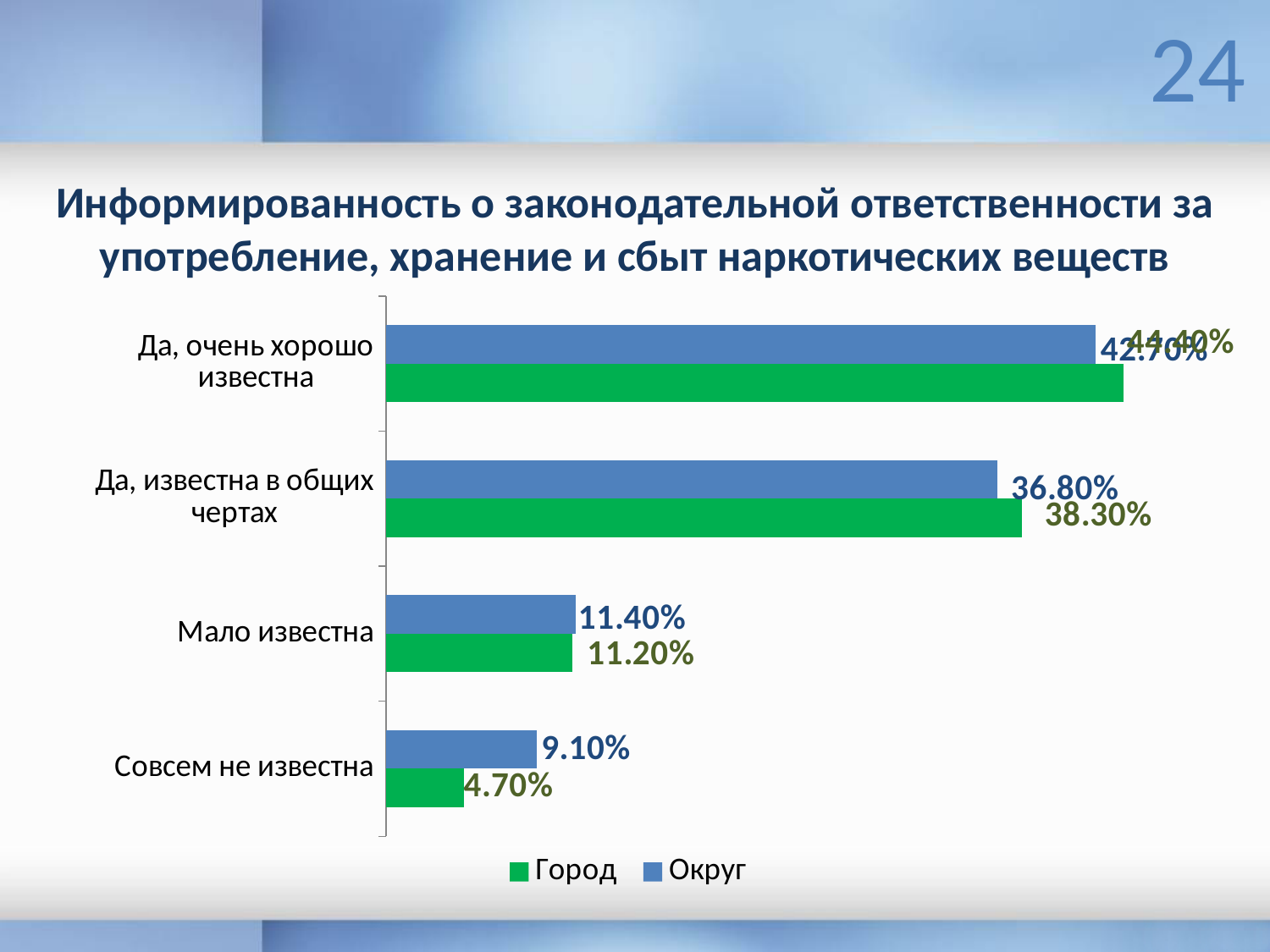
What is the value for Город in the category "Совсем не известна"? 4.70% What is the value for Округ in the category "Совсем не известна"? 9.10% What is the difference between the Округ and Город values in the category "Совсем не известна"? 4.40% What is the value for Округ in the category "Мало известна"? 11.40% What kind of chart is shown on the slide? bar chart In the category "Совсем не известна", which series has the larger value, Город or Округ? Округ How many categories are shown on the chart? 4 How many series does the legend list? 2 What is the value for Округ in the category "Да, известна в общих чертах"? 36.80% Which category has the lowest value for the Город series? Совсем не известна Which colour represents the Город series in the legend? green What is the value for Город in the category "Да, известна в общих чертах"? 38.30%